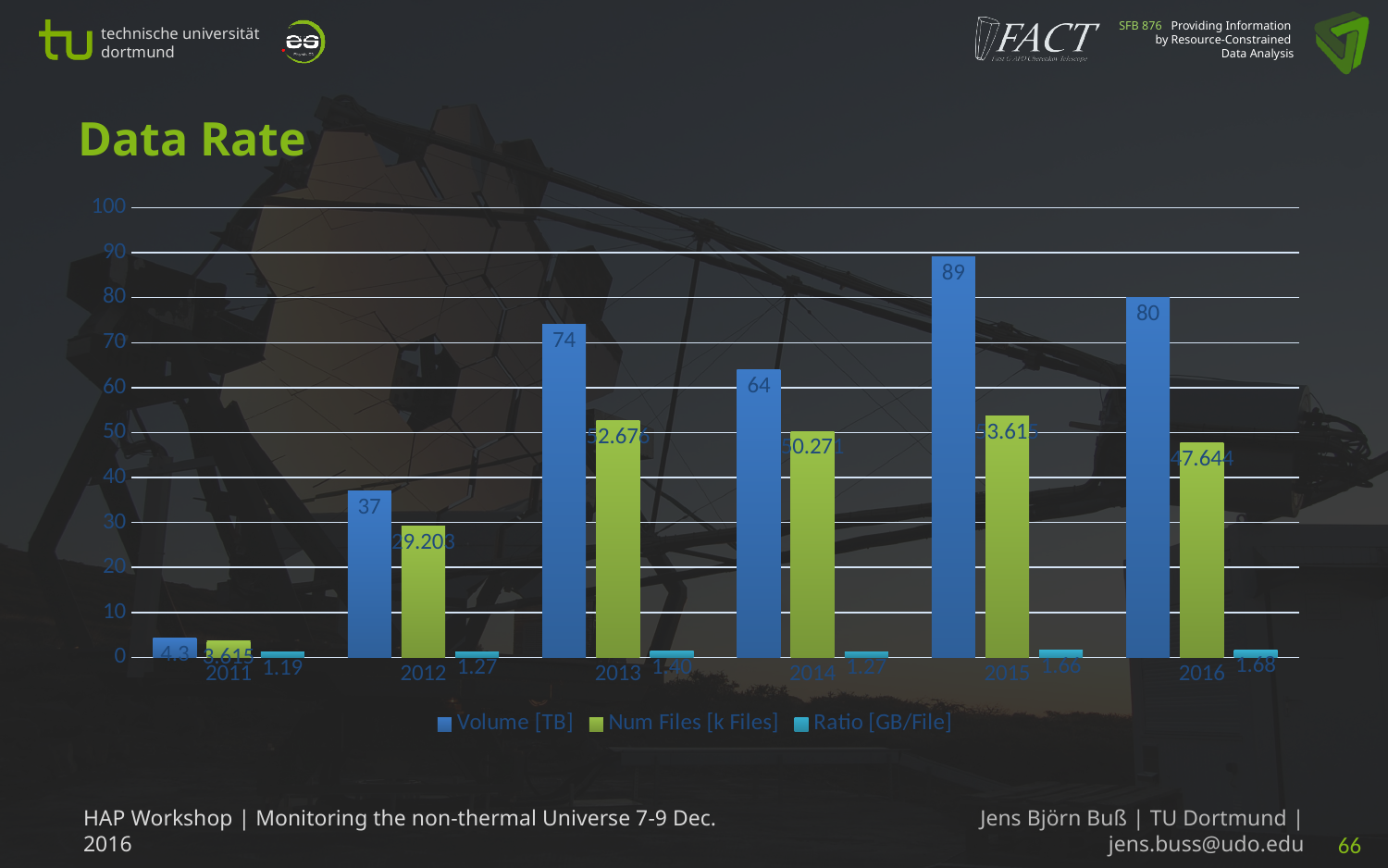
What is the Num Files [k Files] value for 2011? 3.615 What is the Volume [TB] value for 2013? 74 How many series does the legend list? 3 Which year has the lowest Volume [TB]? 2011 What is the Volume [TB] value for 2015? 89 Which is larger, the Volume [TB] for 2013 or for 2014? 2013 What is the Ratio [GB/File] value for 2016? 1.68 Is the Num Files [k Files] value for 2015 greater or less than 50? greater How many years are shown on the x axis? 6 What kind of chart is shown on the slide? bar chart Which year has the highest Volume [TB]? 2015 What is the difference in Volume [TB] between 2015 and 2016? 9